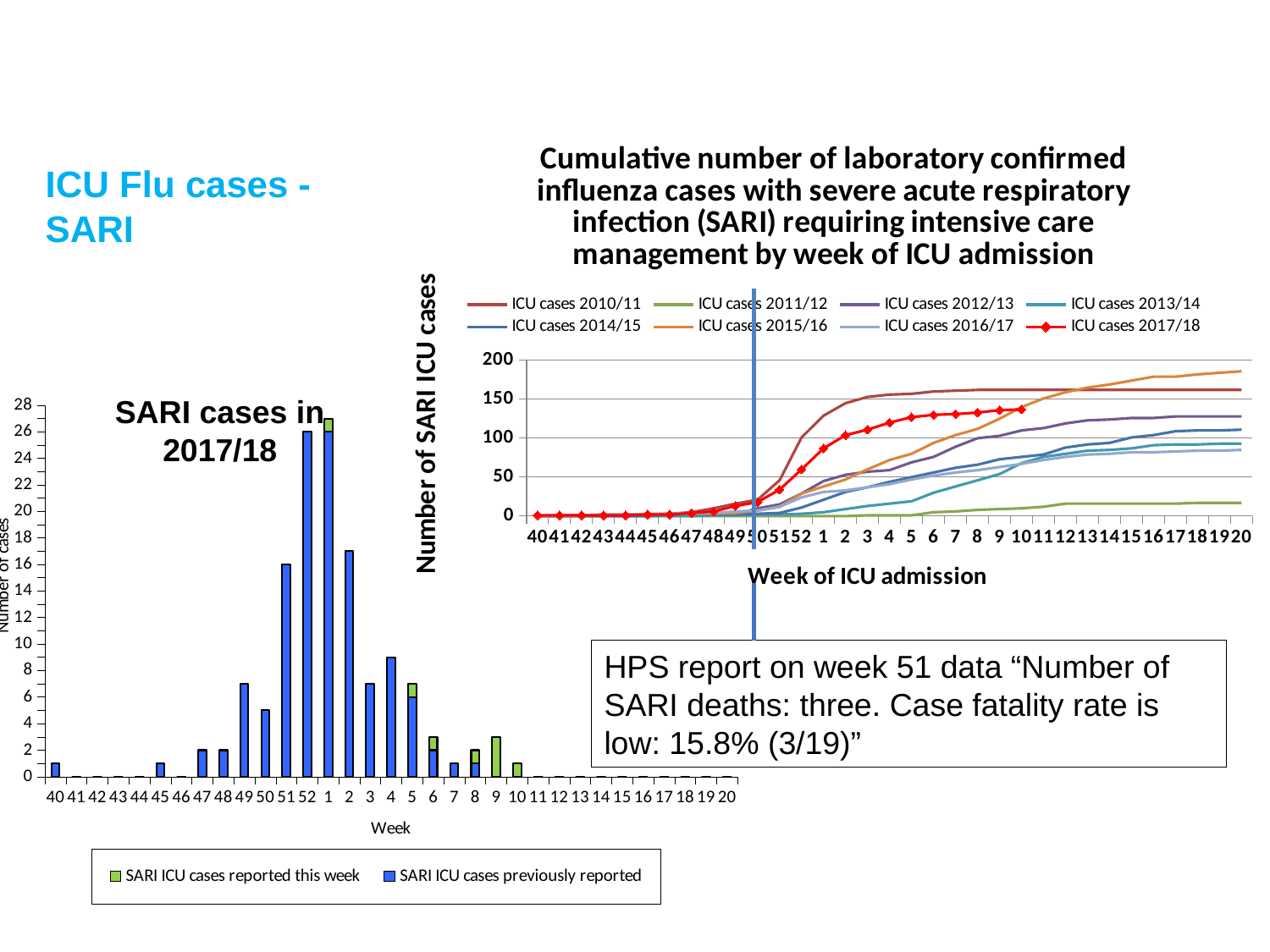
In the 'SARI cases in 2017/18' bar chart, is the value for week 52 greater or less than 20? greater In the cumulative line chart on the right, which series reaches the highest value at week 20? ICU cases 2015/16 In the 'SARI cases in 2017/18' bar chart, is the value for week 3 greater or less than 10? less What kind of chart is the 'Cumulative number of laboratory confirmed influenza cases...' chart on the right? line chart In the cumulative line chart on the right, what is the x-axis title? Week of ICU admission In the 'SARI cases in 2017/18' bar chart, which week has the tallest bar? Week 1 How many series does the legend of the cumulative line chart on the right list? 8 In the cumulative line chart on the right, which series has the lowest values at the end of the season? ICU cases 2011/12 What kind of chart is the 'SARI cases in 2017/18' chart on the left? bar chart In the 'SARI cases in 2017/18' bar chart, is the value for week 2 greater or less than 10? greater How many series does the legend of the 'SARI cases in 2017/18' bar chart list? 2